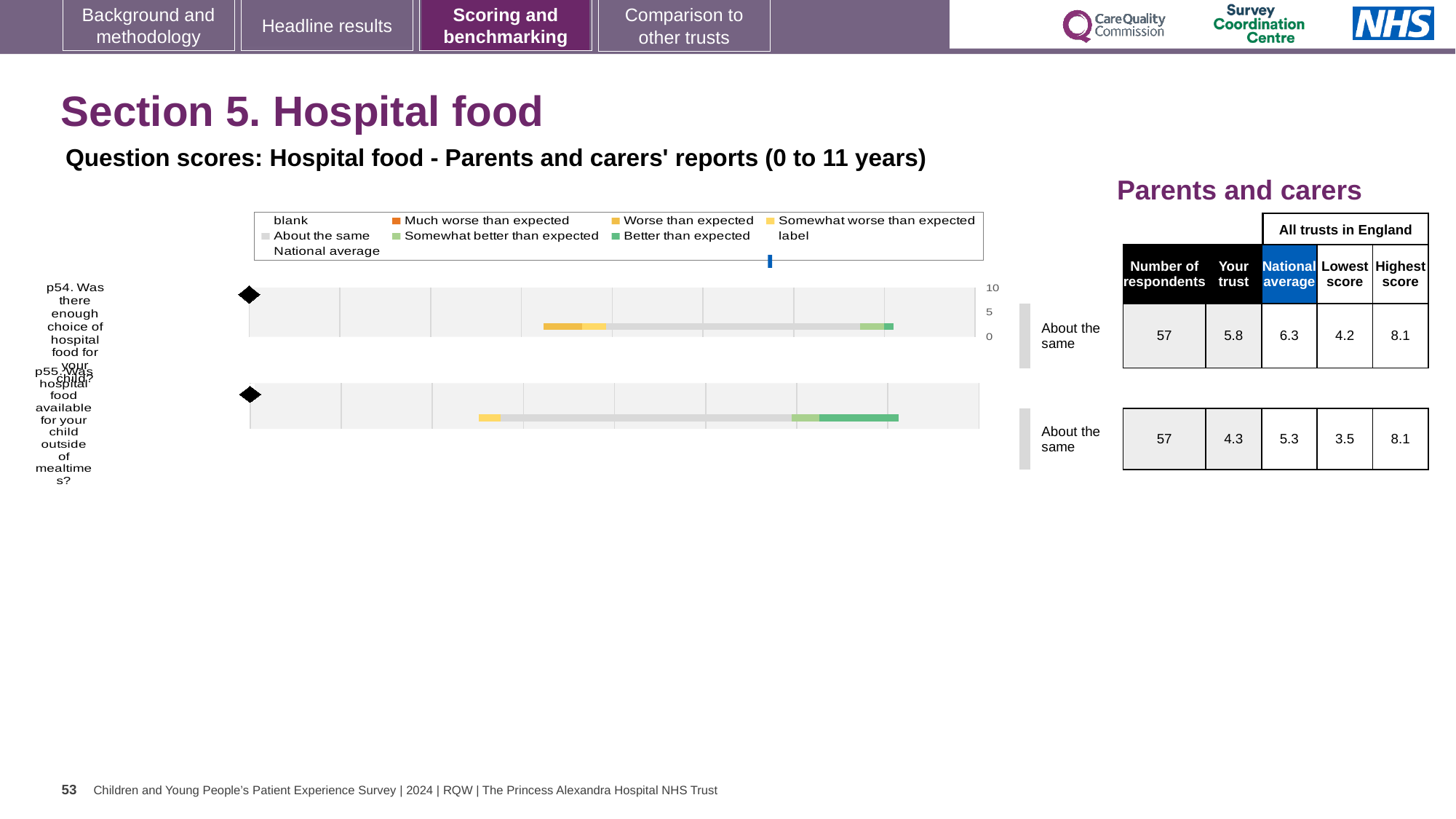
Is the 'Your trust' score for p55 greater or less than 5? less How many questions (categories) are plotted in the hospital food chart? 2 What is the difference between the national average and the 'Your trust' score for p54? 0.5 What kind of chart is used to show the question scores for hospital food? bar chart What is the difference between the highest score and the lowest score for p55? 4.6 What colour does the legend use for 'Better than expected'? green What is the 'Your trust' score for p54 (Was there enough choice of hospital food for your child?)? 5.8 Which question has the higher 'Your trust' score, p54 or p55? p54 What benchmark category is shown for p55? About the same What is the national average score for p55 (Was hospital food available for your child outside of mealtimes?)? 5.3 What is the lowest score across all trusts in England for p54? 4.2 How many respondents answered p54? 57